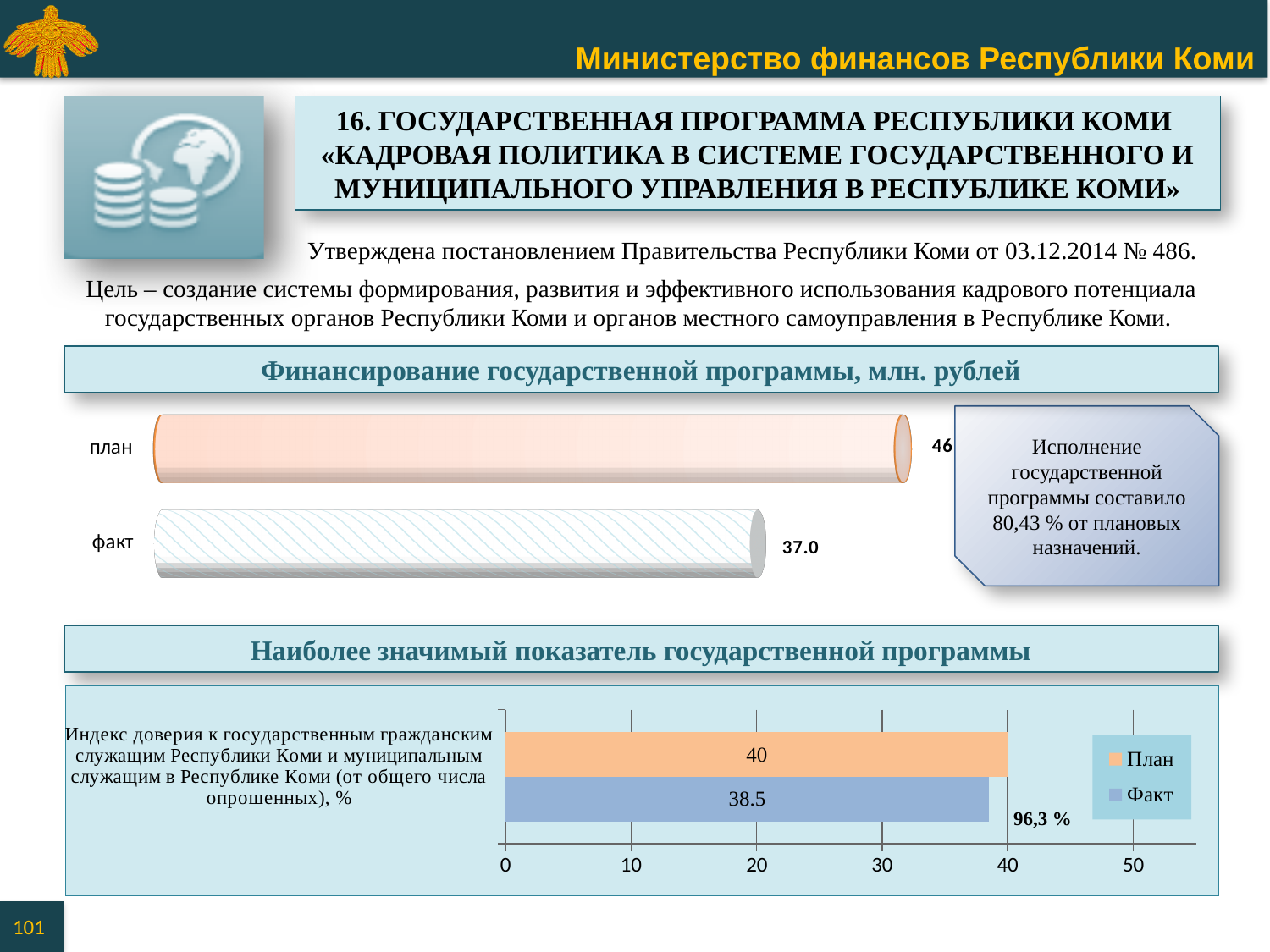
How many bars are shown in the chart 'Финансирование государственной программы, млн. рублей'? 2 What kind of chart is 'Наиболее значимый показатель государственной программы'? bar chart In the chart 'Наиболее значимый показатель государственной программы', what is the value for План? 40 What kind of chart is 'Финансирование государственной программы, млн. рублей'? bar chart In the chart 'Наиболее значимый показатель государственной программы', what is the value for Факт? 38.5 In the chart 'Наиболее значимый показатель государственной программы', what is the difference between План and Факт? 1.5 In the chart 'Наиболее значимый показатель государственной программы', which is larger, План or Факт? План In the chart 'Наиболее значимый показатель государственной программы', what is the highest value shown on the x axis? 50 In the chart 'Финансирование государственной программы, млн. рублей', what is the value for факт? 37.0 In the chart 'Финансирование государственной программы, млн. рублей', which bar is longer, план or факт? план In the chart 'Наиболее значимый показатель государственной программы', is the value for Факт greater or less than 40? less How many series does the legend list in the chart 'Наиболее значимый показатель государственной программы'? 2